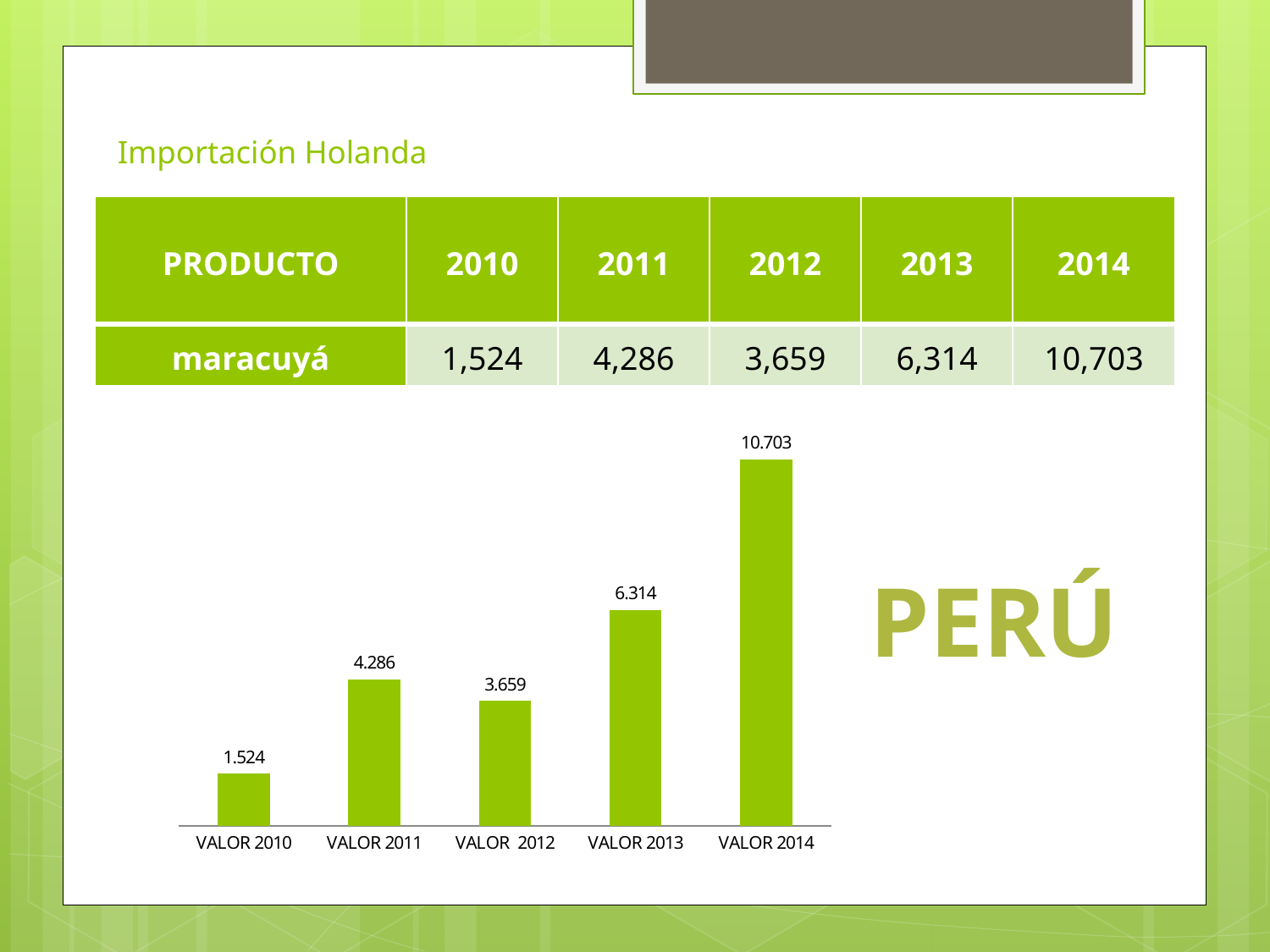
What is the value shown for VALOR 2010 in the bar chart? 1.524 Which is larger, the value for VALOR 2011 or the value for VALOR 2012? VALOR 2011 Which category has the lowest bar in the chart? VALOR 2010 Which category has the highest bar in the chart? VALOR 2014 What kind of chart is shown on the slide? Bar chart What is the difference between the values for VALOR 2014 and VALOR 2013? 4.389 What is the value shown for VALOR 2012 in the bar chart? 3.659 What colour are the bars in the chart? Green How many bars are plotted in the chart? 5 What is the value shown for VALOR 2014 in the bar chart? 10.703 What is the difference between the values for VALOR 2011 and VALOR 2012? 627 Does the value rise or fall from VALOR 2013 to VALOR 2014? Rise